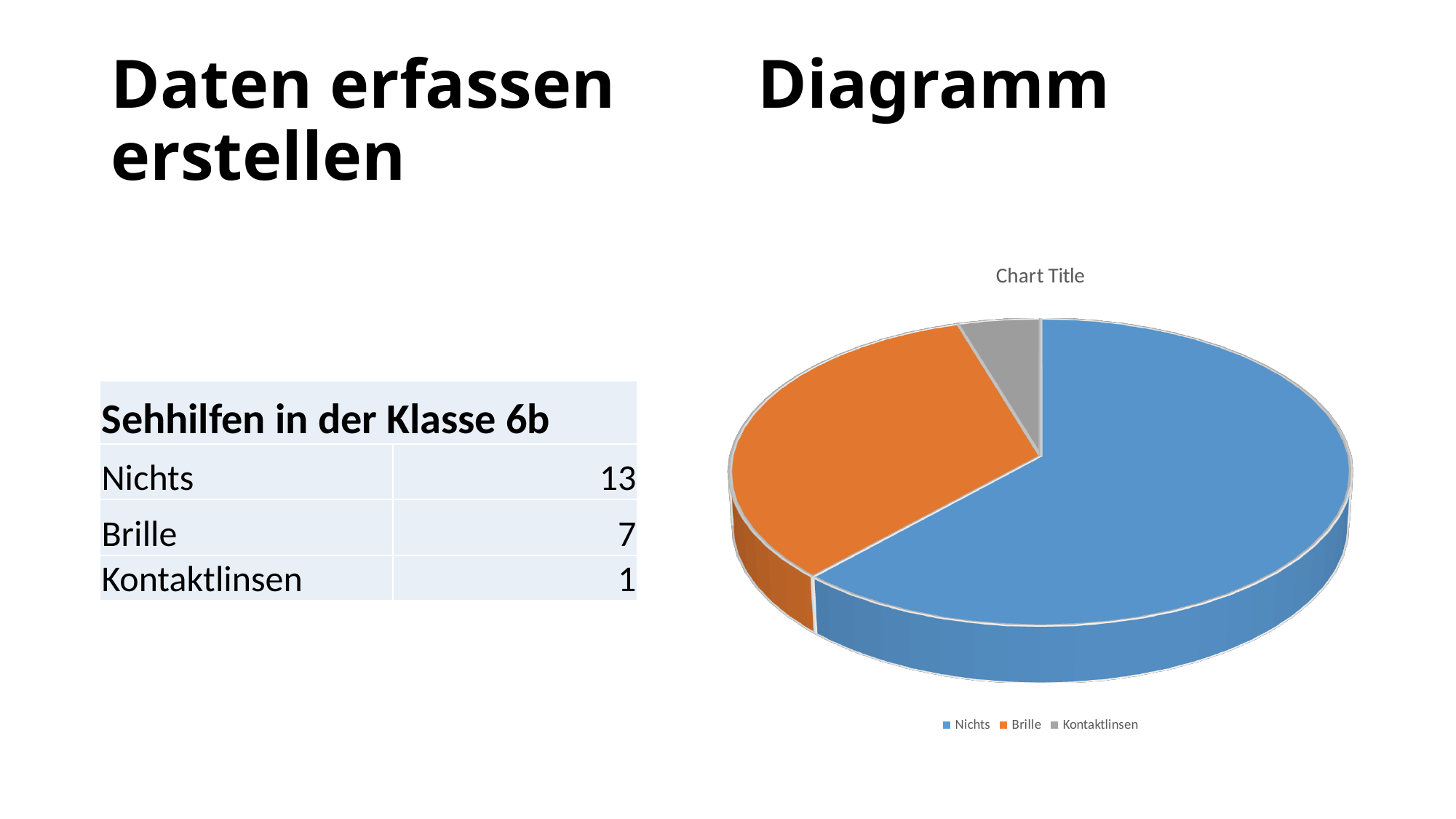
What title is displayed above the pie chart? Chart Title What kind of chart is shown on the slide? pie chart According to the table on the slide, what is the value for Kontaktlinsen? 1 Which category has the smallest slice in the pie chart? Kontaktlinsen How many entries does the legend of the pie chart list? 3 According to the table on the slide, what is the value for Nichts? 13 Which category has the largest slice in the pie chart? Nichts How many slices does the pie chart have? 3 Is the slice for Brille larger or smaller than the slice for Kontaktlinsen? larger Is the slice for Brille larger or smaller than the slice for Nichts? smaller According to the table on the slide, what is the value for Brille? 7 What is the difference between the values for Nichts and Brille shown in the table? 6